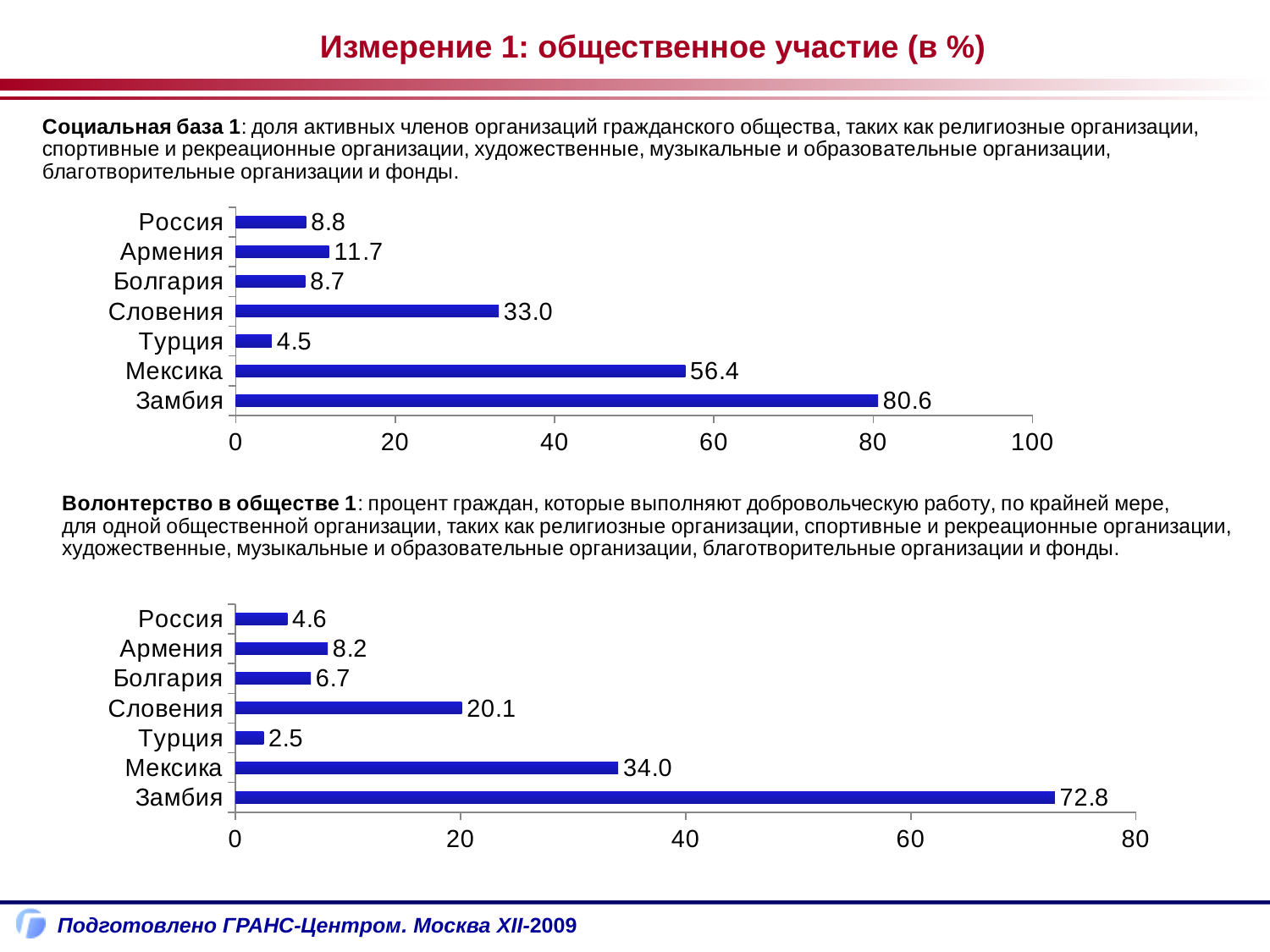
In the top chart (Социальная база 1), how many countries are shown? 7 In the bottom chart (Волонтерство в обществе 1), which country has the highest value? Замбия In the bottom chart (Волонтерство в обществе 1), what is the difference between the values for Армения and Россия? 3.6 In the bottom chart (Волонтерство в обществе 1), what is the value for Мексика? 34.0 In the top chart (Социальная база 1), what is the difference between the values for Замбия and Мексика? 24.2 In the top chart (Социальная база 1), what is the value for Словения? 33.0 In the top chart (Социальная база 1), which is larger, the value for Армения or the value for Россия? Армения In the bottom chart (Волонтерство в обществе 1), what is the value for Турция? 2.5 In the top chart (Социальная база 1), which country has the highest value? Замбия In the bottom chart (Волонтерство в обществе 1), what is the maximum value shown on the horizontal axis? 80 What kind of chart is the bottom chart (Волонтерство в обществе 1)? bar chart In the top chart (Социальная база 1), which country has the lowest value? Турция